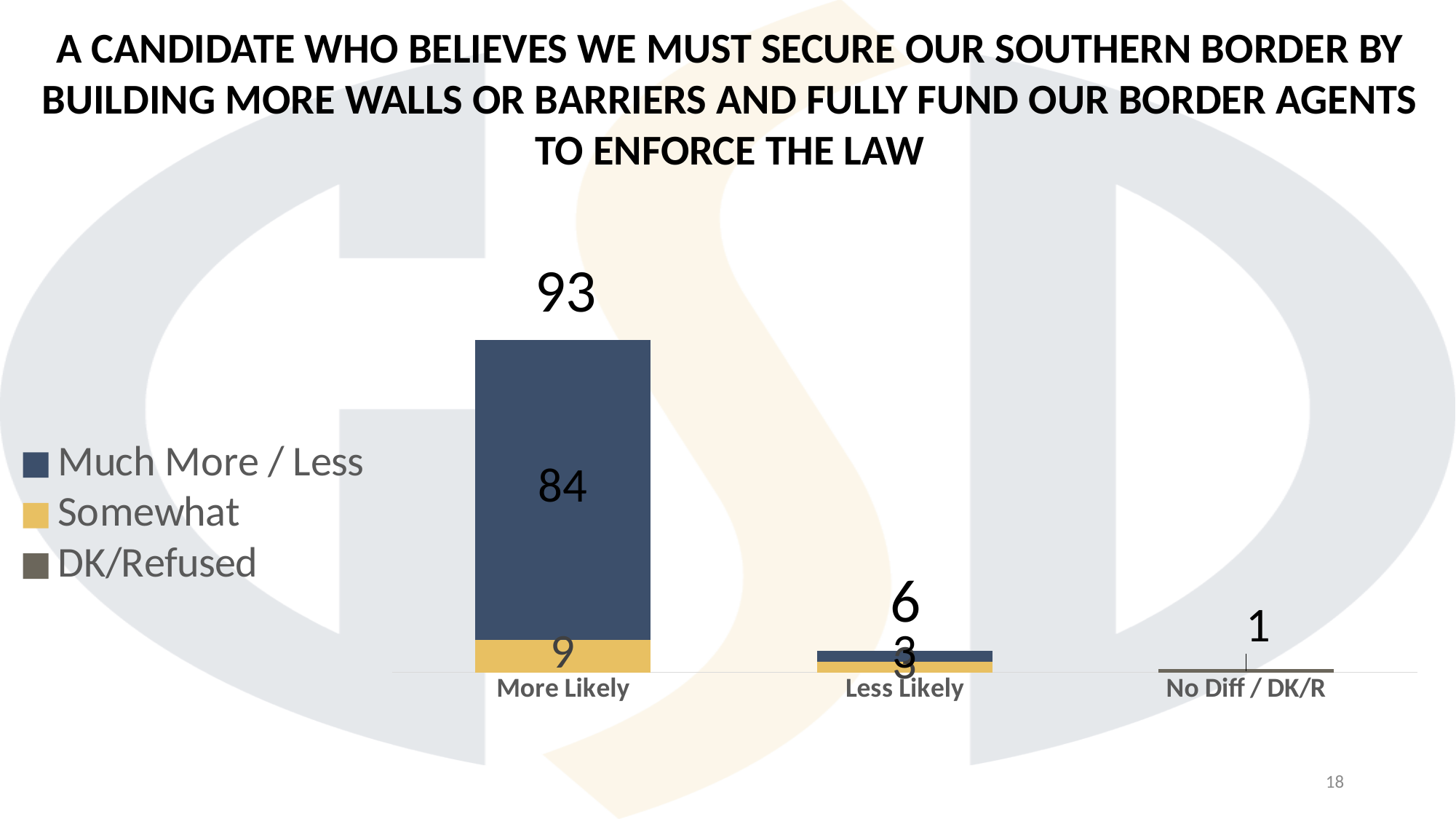
What is the Much More / Less value for More Likely? 84 What kind of chart is shown on the slide? Stacked bar chart What is the total value shown above the More Likely bar? 93 What is the total value shown above the Less Likely bar? 6 Which is larger, the Much More / Less value for More Likely or the Somewhat value for More Likely? Much More / Less How many categories are shown on the x axis? 3 What is the Somewhat value for More Likely? 9 Which category has the lowest total? No Diff / DK/R Which category has the highest total? More Likely How many series does the legend list? 3 What is the difference between the More Likely total and the Less Likely total? 87 What is the value shown for No Diff / DK/R? 1